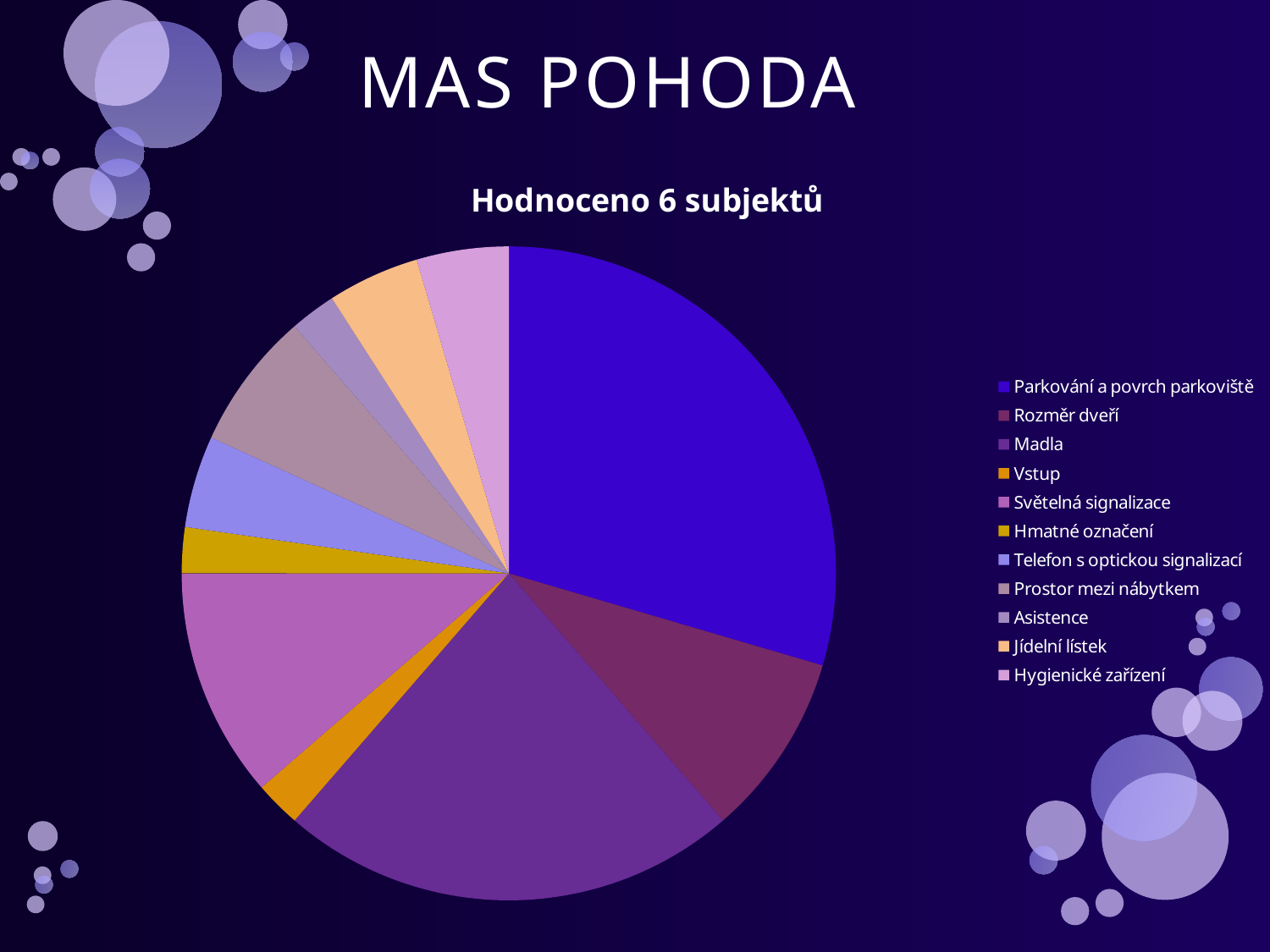
Which category has the largest slice of the pie? Parkování a povrch parkoviště Which category is listed first in the legend? Parkování a povrch parkoviště Which slice is larger, Vstup or Madla? Madla What kind of chart is shown on the slide? pie chart Which slice is larger, Rozměr dveří or Telefon s optickou signalizací? Rozměr dveří Which slice is larger, Prostor mezi nábytkem or Asistence? Prostor mezi nábytkem What is the title of the chart? Hodnoceno 6 subjektů How many categories does the legend of the pie chart list? 11